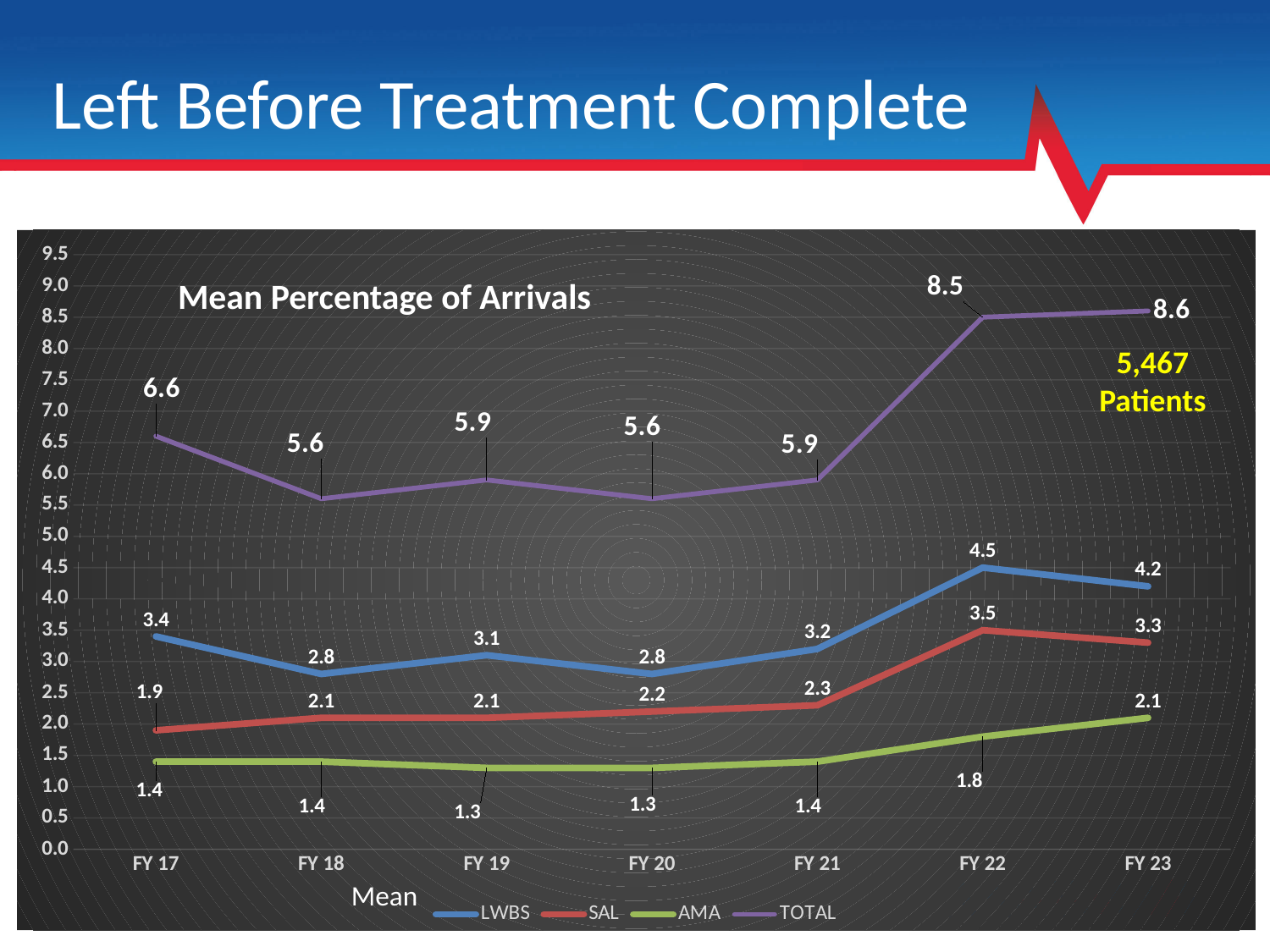
What is the difference between the TOTAL values for FY 22 and FY 21? 2.6 What is the TOTAL value for FY 23? 8.6 What is the LWBS value for FY 22? 4.5 What is the AMA value for FY 19? 1.3 What kind of chart is shown on the slide? line chart In which fiscal year is the LWBS value lowest? FY 18 and FY 20 How many series does the legend list? 4 In which fiscal year is the TOTAL value highest? FY 23 Which is larger, the SAL value for FY 22 or the LWBS value for FY 18? SAL for FY 22 What is the SAL value for FY 17? 1.9 What is the title shown inside the chart area? Mean Percentage of Arrivals How many fiscal years are plotted on the x axis? 7